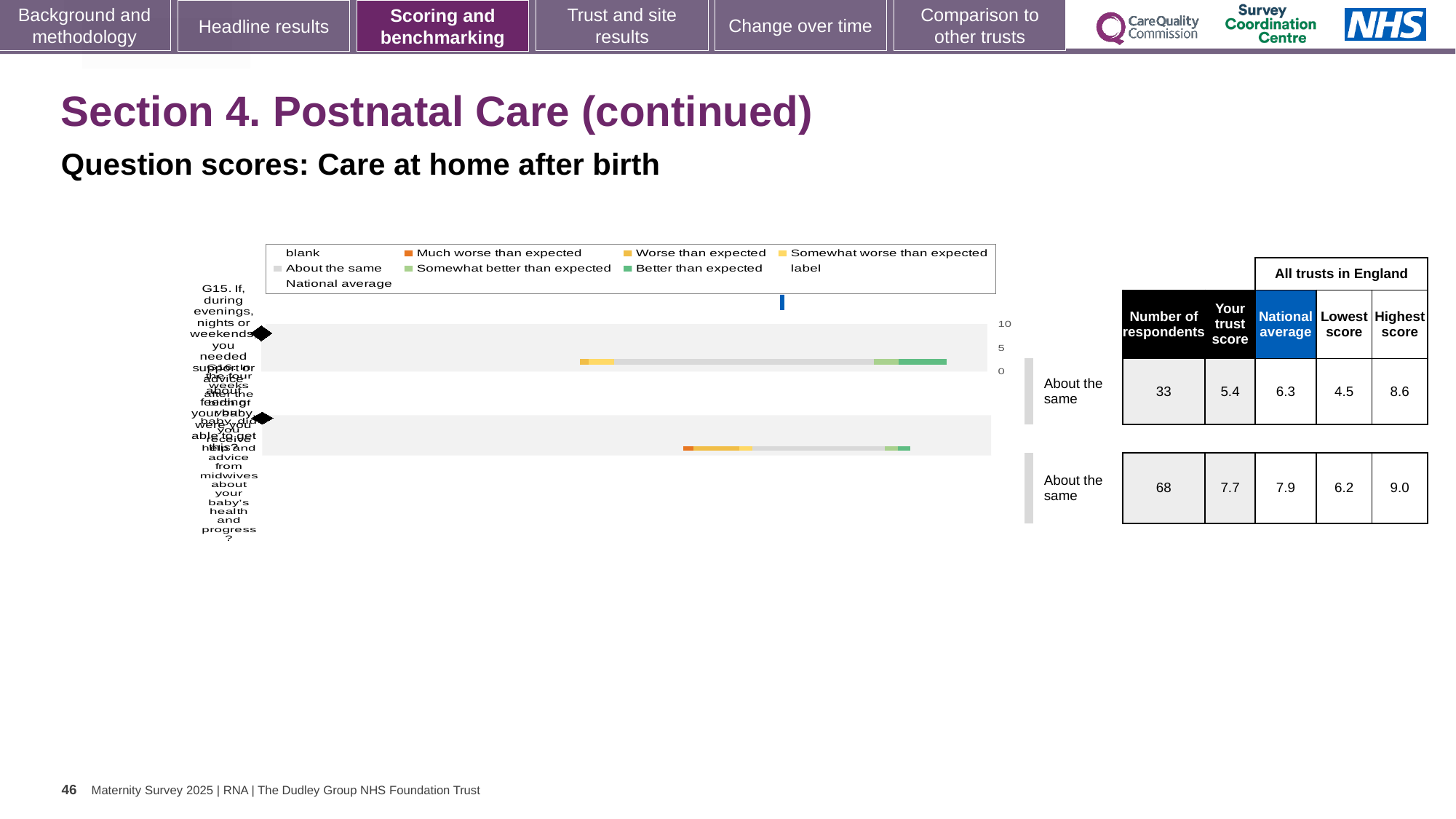
In the table beside the chart, what is the trust score for the first question (G15)? 5.4 What colour does the legend use for 'Much worse than expected'? orange In the table beside the chart, what is the difference between the highest score and the lowest score for G16? 2.8 What is the highest value shown on the chart's axis? 10 In the table beside the chart, which is larger for G15: the trust score or the national average? national average What colour does the legend use for 'Better than expected'? green How many question bars are plotted in the chart? 2 In the table beside the chart, what is the national average for the second question (G16)? 7.9 In the table beside the chart, what is the benchmark category shown for both questions? About the same In the table beside the chart, how many respondents answered the second question (G16)? 68 What kind of chart is shown on the slide? bar chart